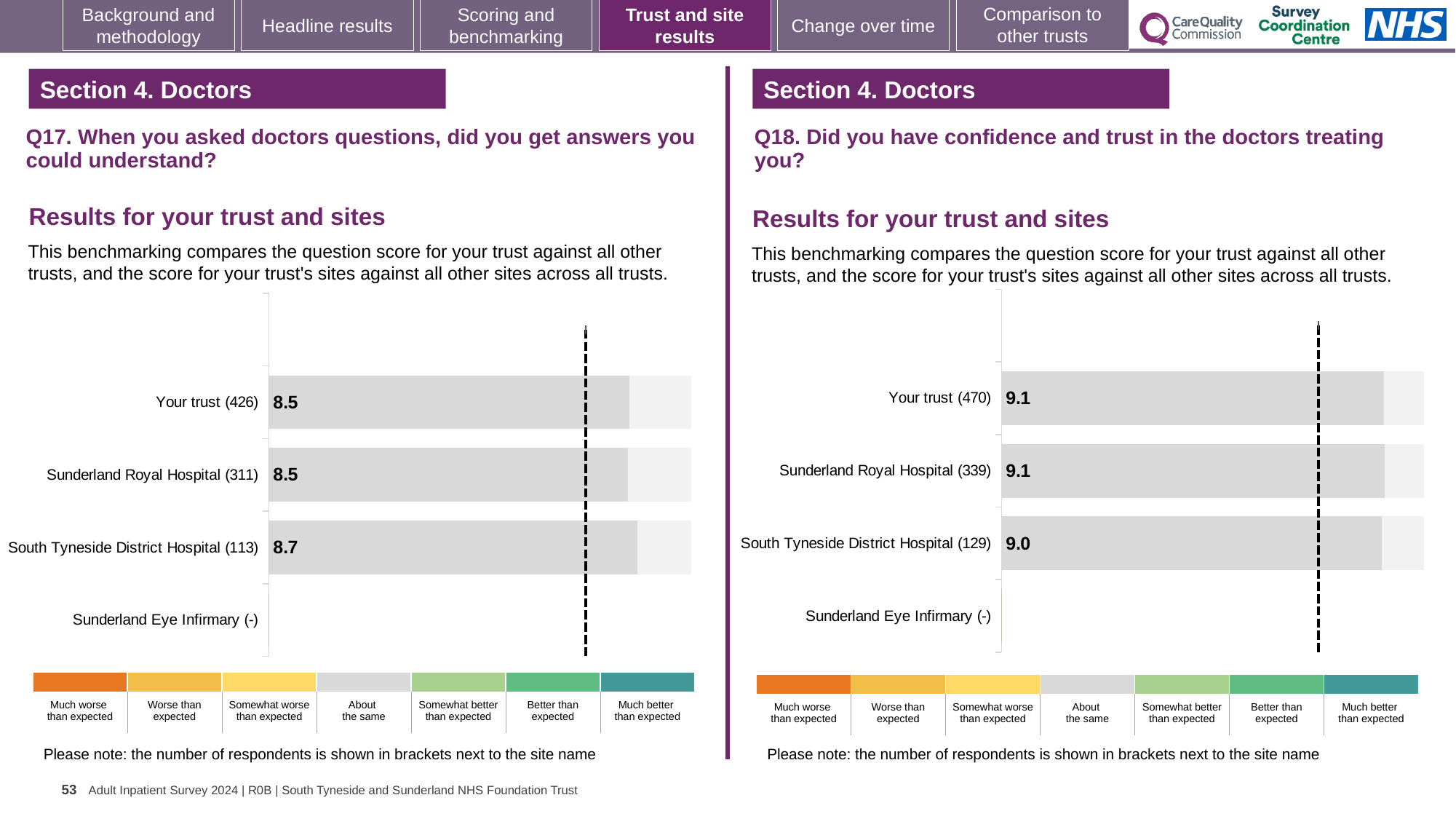
In the Q18 chart on the right, how many respondents are shown for Your trust? 470 In the Q17 chart on the left, what is the score for South Tyneside District Hospital? 8.7 In the Q18 chart on the right, how many site or trust rows are listed on the vertical axis? 4 In the Q17 chart on the left, what is the difference between the scores for South Tyneside District Hospital and Sunderland Royal Hospital? 0.2 In the Q18 chart on the right, which of Sunderland Royal Hospital or South Tyneside District Hospital has the higher score? Sunderland Royal Hospital In the Q17 chart on the left, how many respondents are shown for Sunderland Royal Hospital? 311 In the Q18 chart on the right, what is the score for Your trust? 9.1 What kind of chart is used in the Q17 chart on the left? Bar chart In the Q17 chart on the left, which site has the highest score? South Tyneside District Hospital In the Q17 chart on the left, what is the score for Your trust? 8.5 In the Q18 chart on the right, what is the score for South Tyneside District Hospital? 9.0 In the Q17 chart on the left, which site has no score shown (marked with a dash)? Sunderland Eye Infirmary